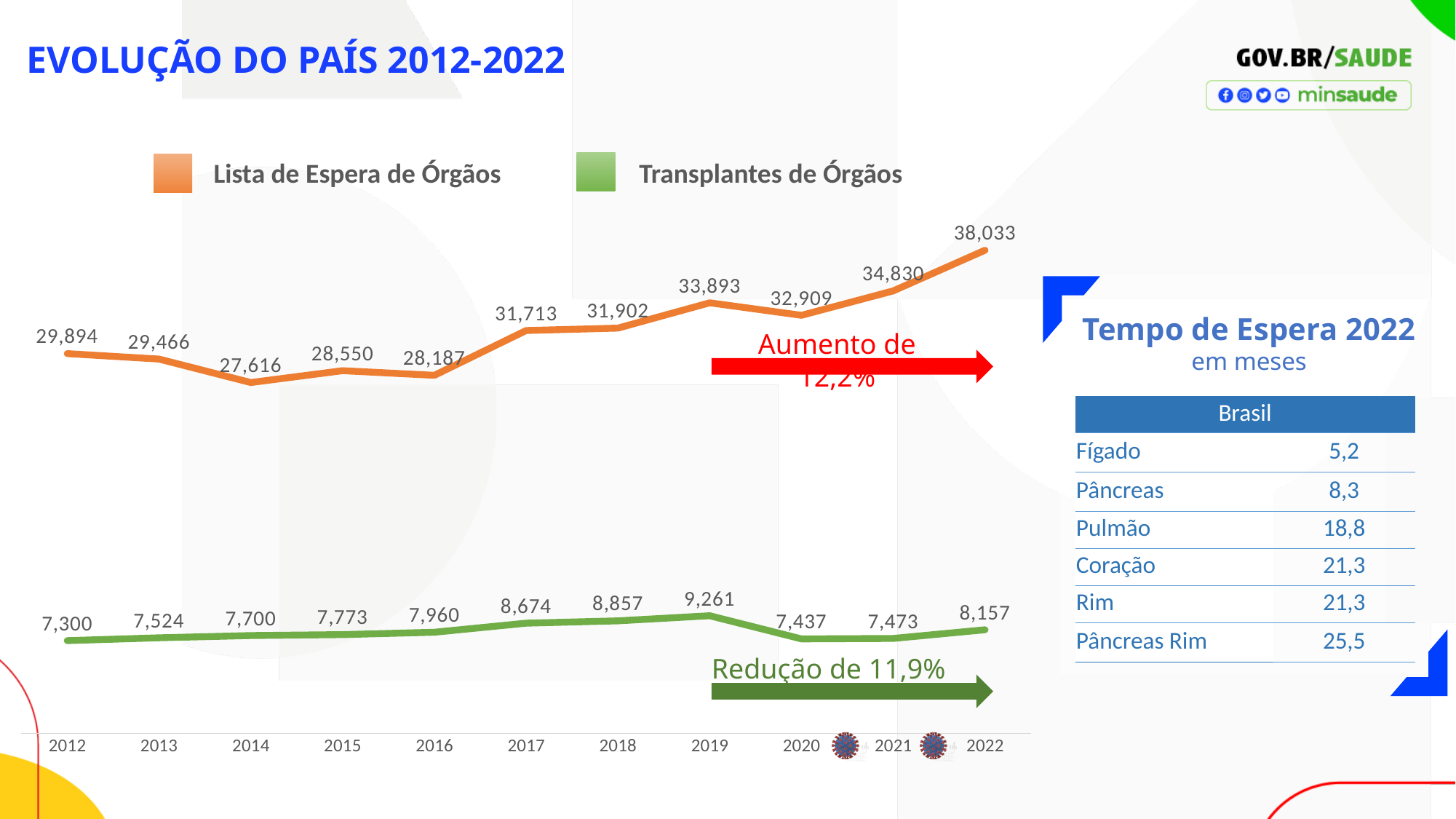
What is the difference between Transplantes de Órgãos in 2019 and 2020? 1,824 Which year has a higher value for Transplantes de Órgãos, 2020 or 2021? 2021 In which year is Lista de Espera de Órgãos lowest? 2014 What is the value of Lista de Espera de Órgãos in 2022? 38,033 By how much did Lista de Espera de Órgãos increase from 2012 to 2022? 8,139 How many years are shown on the x axis of the chart? 11 What is the value of Lista de Espera de Órgãos in 2014? 27,616 What is the value of Transplantes de Órgãos in 2019? 9,261 How many series does the chart legend list? 2 What kind of chart is shown on the slide? Line chart In which year is Transplantes de Órgãos highest? 2019 Does Transplantes de Órgãos rise or fall from 2012 to 2019? Rise